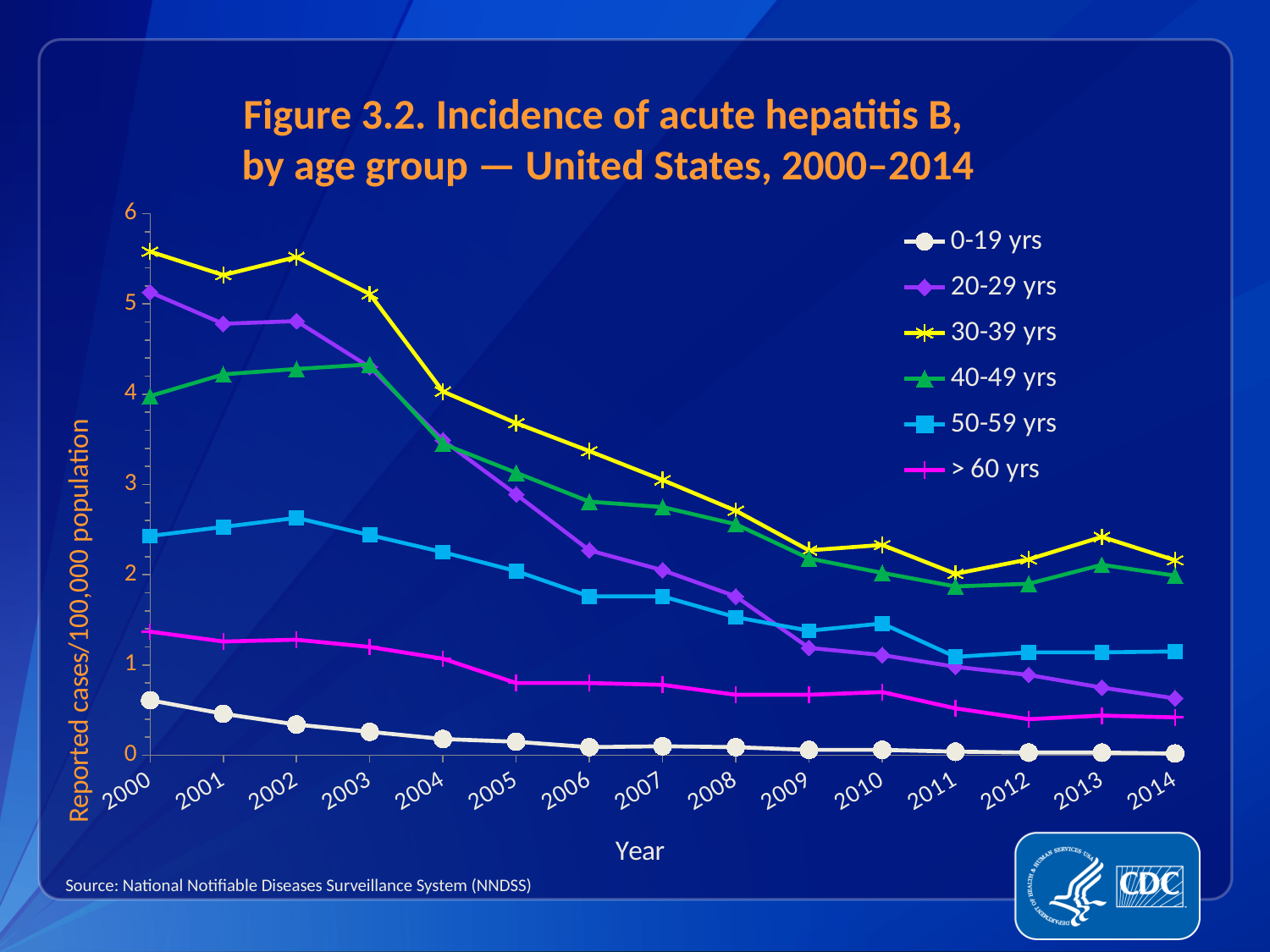
Which age group has the highest incidence in 2000? 30-39 yrs In 2014, which is larger: the value for 40-49 yrs or the value for 50-59 yrs? 40-49 yrs Does the incidence for the 30-39 yrs group rise or fall from 2000 to 2014? fall Is the value for the 30-39 yrs group in 2000 greater or less than 5? greater Which age group has the lowest incidence in 2000? 0-19 yrs How many years are plotted along the x axis? 15 Is the value for the 20-29 yrs group in 2014 greater or less than 1? less What is the label of the y axis? Reported cases/100,000 population Is the value for the 50-59 yrs group in 2002 greater or less than 2? greater How many age-group series does the legend list? 6 What kind of chart is shown on the slide? line chart In 2000, which is larger: the value for 20-29 yrs or the value for 40-49 yrs? 20-29 yrs